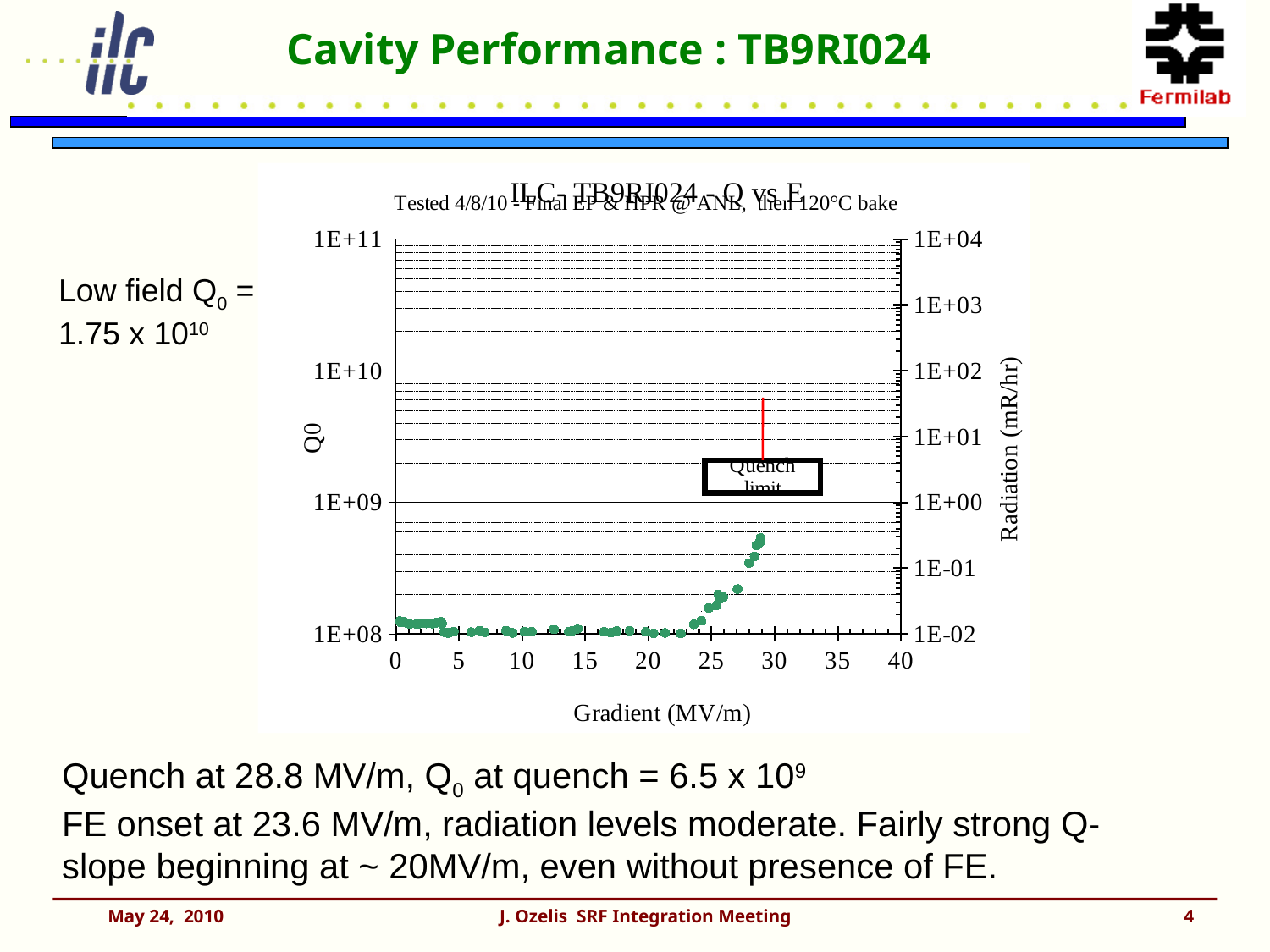
What is the lowest tick value shown on the left y axis (Q0) of the chart? 1E+08 On the right-hand Radiation axis, is the highest green data point greater or less than 1E-01? greater What is the highest tick value shown on the right y axis (Radiation) of the chart? 1E+04 Is the red vertical 'Quench limit' line located at a gradient greater or less than 25 MV/m? greater How many tick labels are shown along the x axis of the chart? 9 As the gradient increases from 25 MV/m to about 29 MV/m, do the plotted green points rise or fall? rise On the right-hand Radiation axis, are the green data points at a gradient of 10 MV/m greater or less than 1E-01? less What kind of chart is shown on the slide? scatter chart What is the label of the right-hand y axis of the chart? Radiation (mR/hr) What is the highest tick value shown on the x axis of the chart? 40 What is the label of the x axis of the chart? Gradient (MV/m)